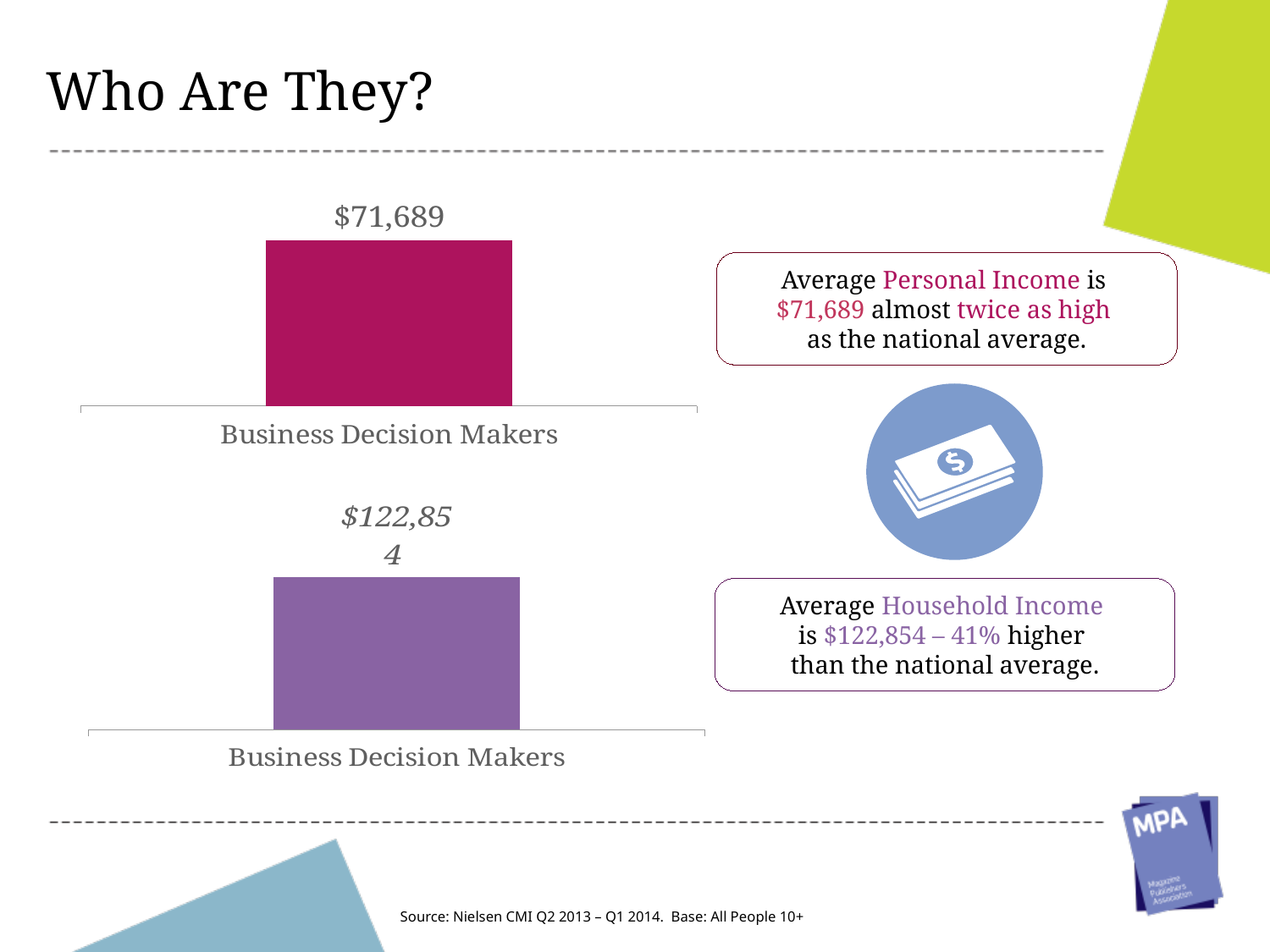
How many bars does the bottom chart contain? 1 What is the difference between the value in the bottom chart and the value in the top chart? $51,165 What kind of chart is the top chart on the slide? Bar chart What kind of chart is the bottom chart on the slide? Bar chart How many bars does the top chart contain? 1 In the bottom chart, what is the value shown for Business Decision Makers? $122,854 In the top chart, what is the value shown for Business Decision Makers? $71,689 What category label appears under the bar in the top chart? Business Decision Makers Which is larger: the value in the top chart or the value in the bottom chart? The bottom chart ($122,854) What colour is the bar in the bottom chart? Purple